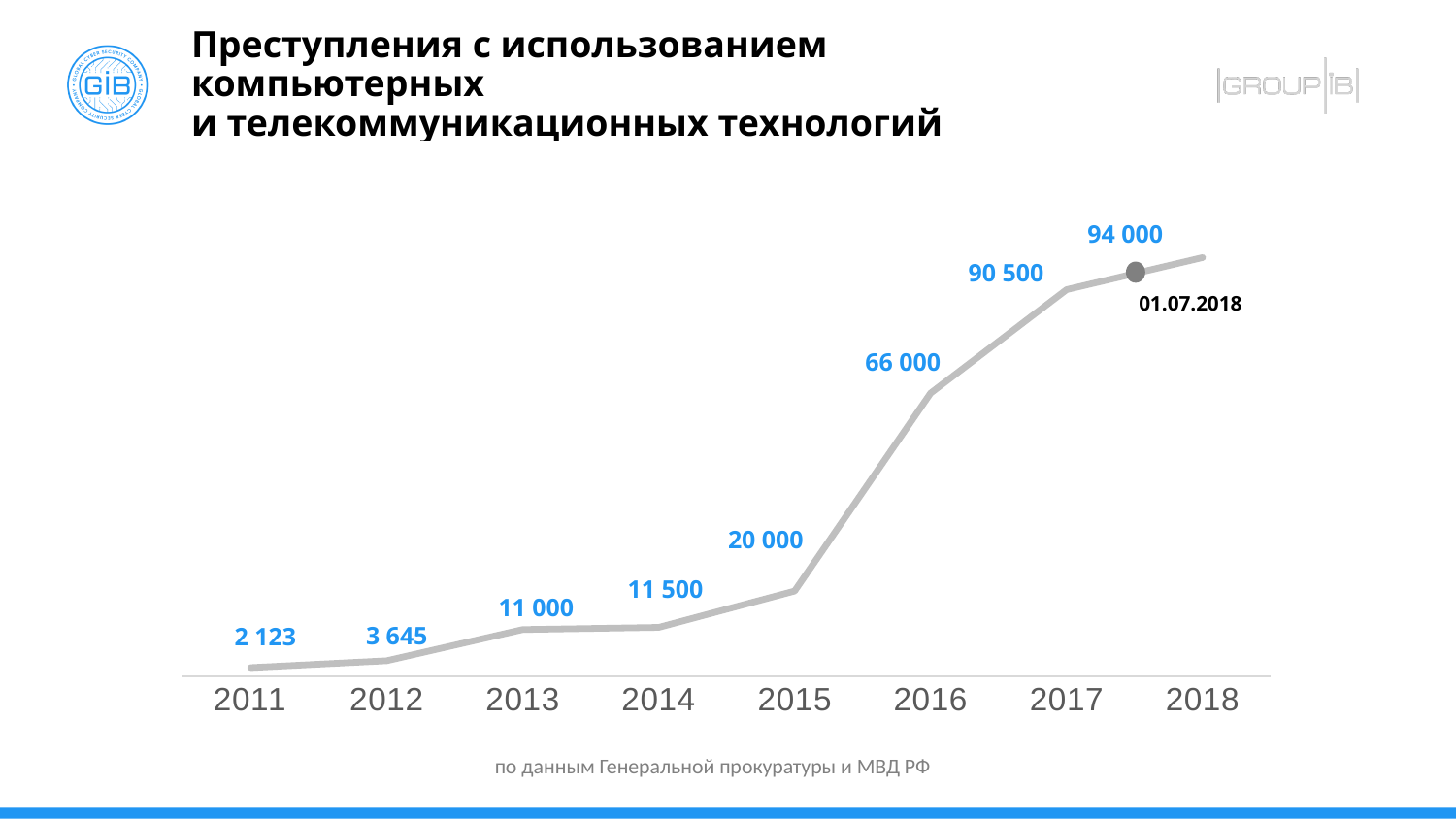
What is the value shown for 2015? 20 000 Which is larger, the value for 2014 or the value for 2013? 2014 What is the value shown for 2016? 66 000 What is the difference between the values for 2012 and 2011? 1 522 What kind of chart is shown on the slide? line chart What is the value shown for 2011? 2 123 Do the values rise or fall from 2011 to 2018? rise What is the value shown for 2013? 11 000 What value is labelled at the point marked 01.07.2018? 94 000 How many years are shown on the x axis? 8 What is the difference between the values for 2016 and 2015? 46 000 Which year has the lowest value on the chart? 2011